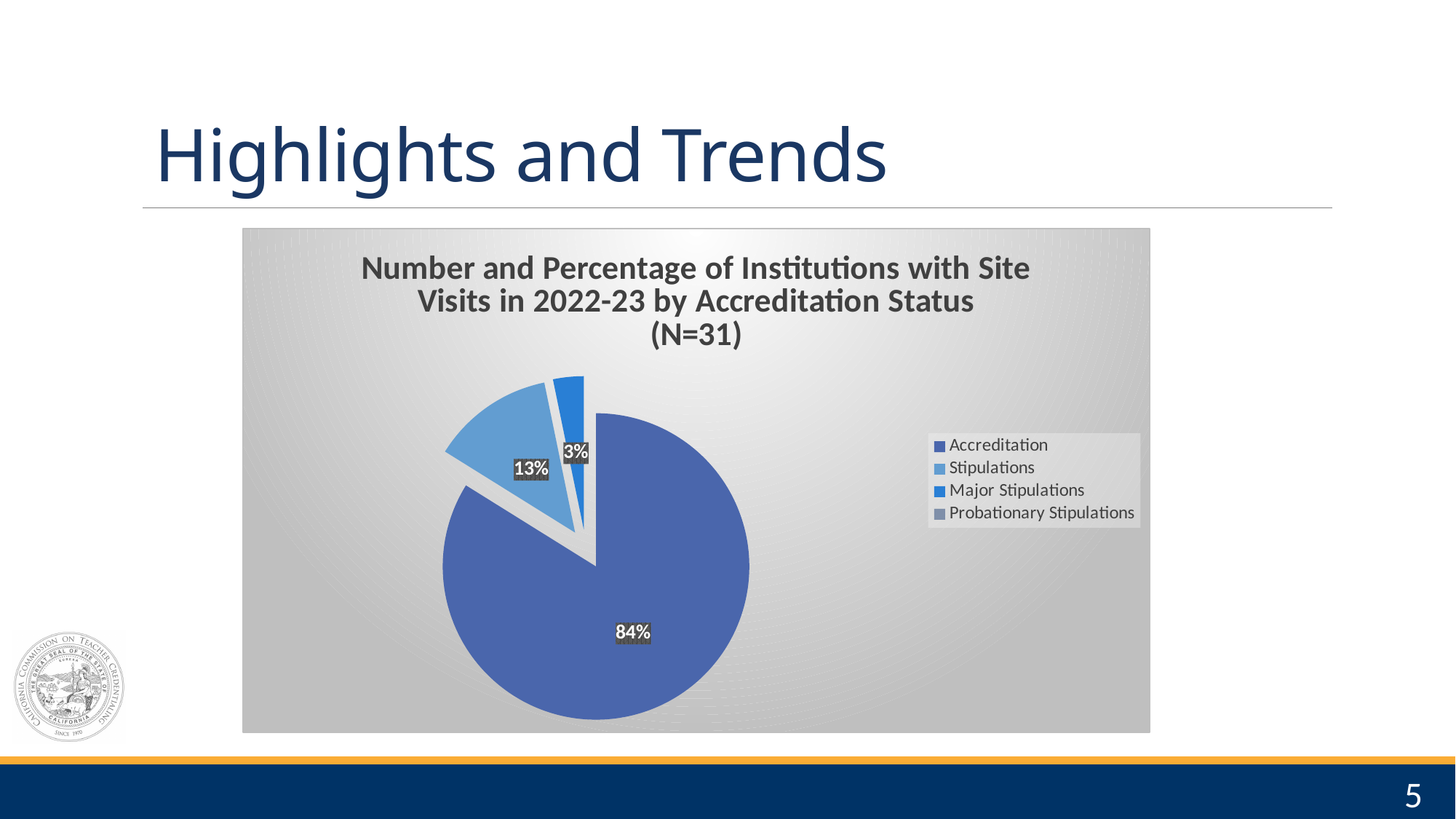
What is the difference in percentage points between the Stipulations slice and the Major Stipulations slice? 10 percentage points Which accreditation status has the largest slice of the pie chart? Accreditation What is the total number of institutions (N) stated in the chart title? 31 How many entries does the chart legend list? 4 What percentage of the pie chart is labelled for Stipulations? 13% What percentage of institutions received Accreditation status according to the pie chart? 84% What is the difference in percentage points between the Accreditation slice and the Stipulations slice? 71 percentage points How many slices in the pie chart have a percentage label? 3 Is the Accreditation slice greater or less than 50% of the pie? greater What type of chart is shown on the slide? Pie chart Which slice is larger, Stipulations or Major Stipulations? Stipulations What percentage is shown for Major Stipulations in the pie chart? 3%